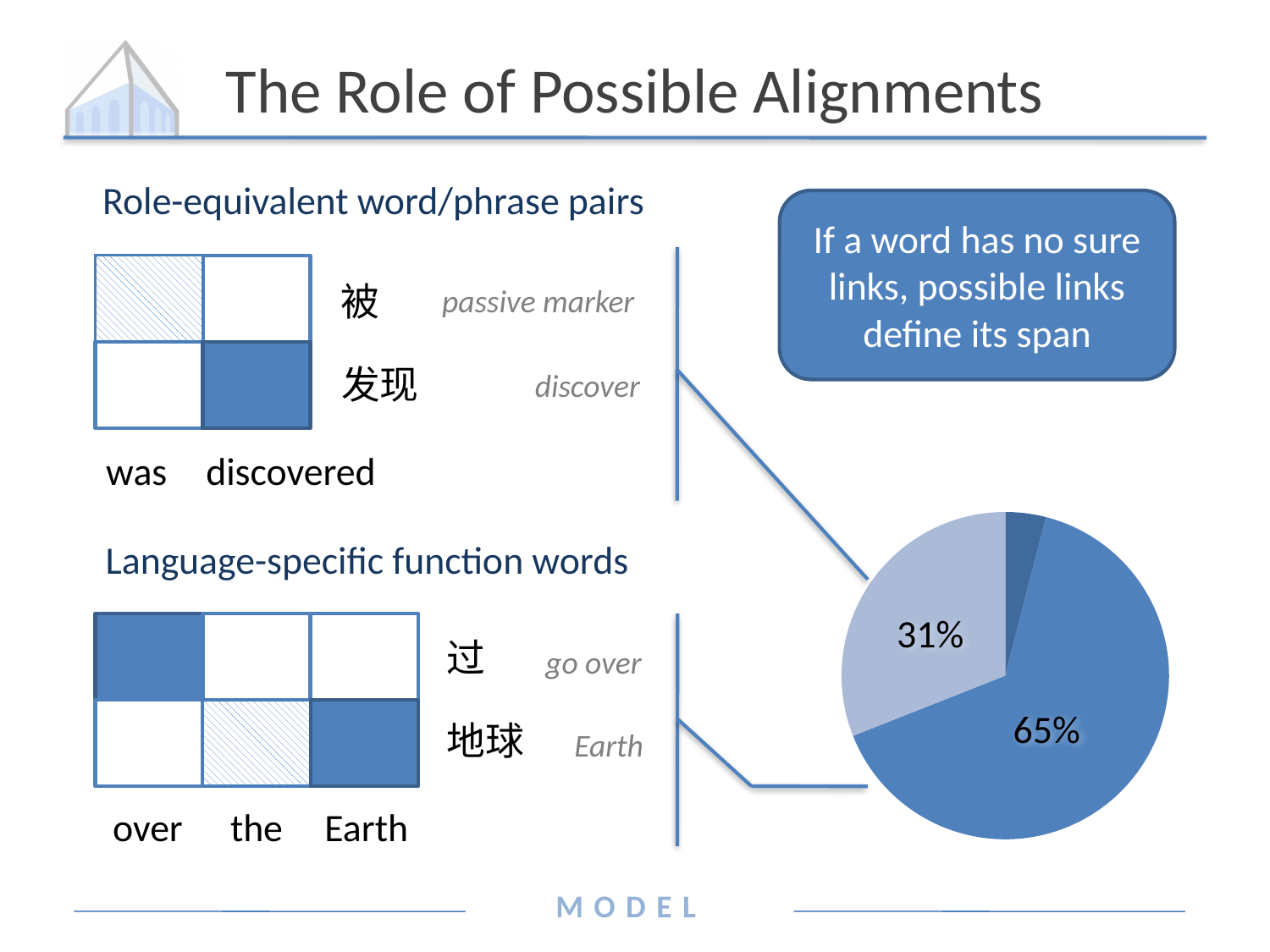
How many slices does the pie chart have? 3 Does the pie chart have a legend? No What is the title of the slide containing the pie chart? The Role of Possible Alignments What is the difference between the two labelled slices of the pie chart (65% and 31%)? 34% What kind of chart is shown on the right side of the slide? pie chart Which slice of the pie chart is larger, the one labelled 65% or the one labelled 31%? 65% What is the value of the largest slice of the pie chart? 65% What is the value of the light blue slice of the pie chart? 31% What share of the pie does the medium blue slice represent? 65% How many slices of the pie chart have a percentage label printed on them? 2 Which slice of the pie chart is the smallest? the small dark blue slice at the top